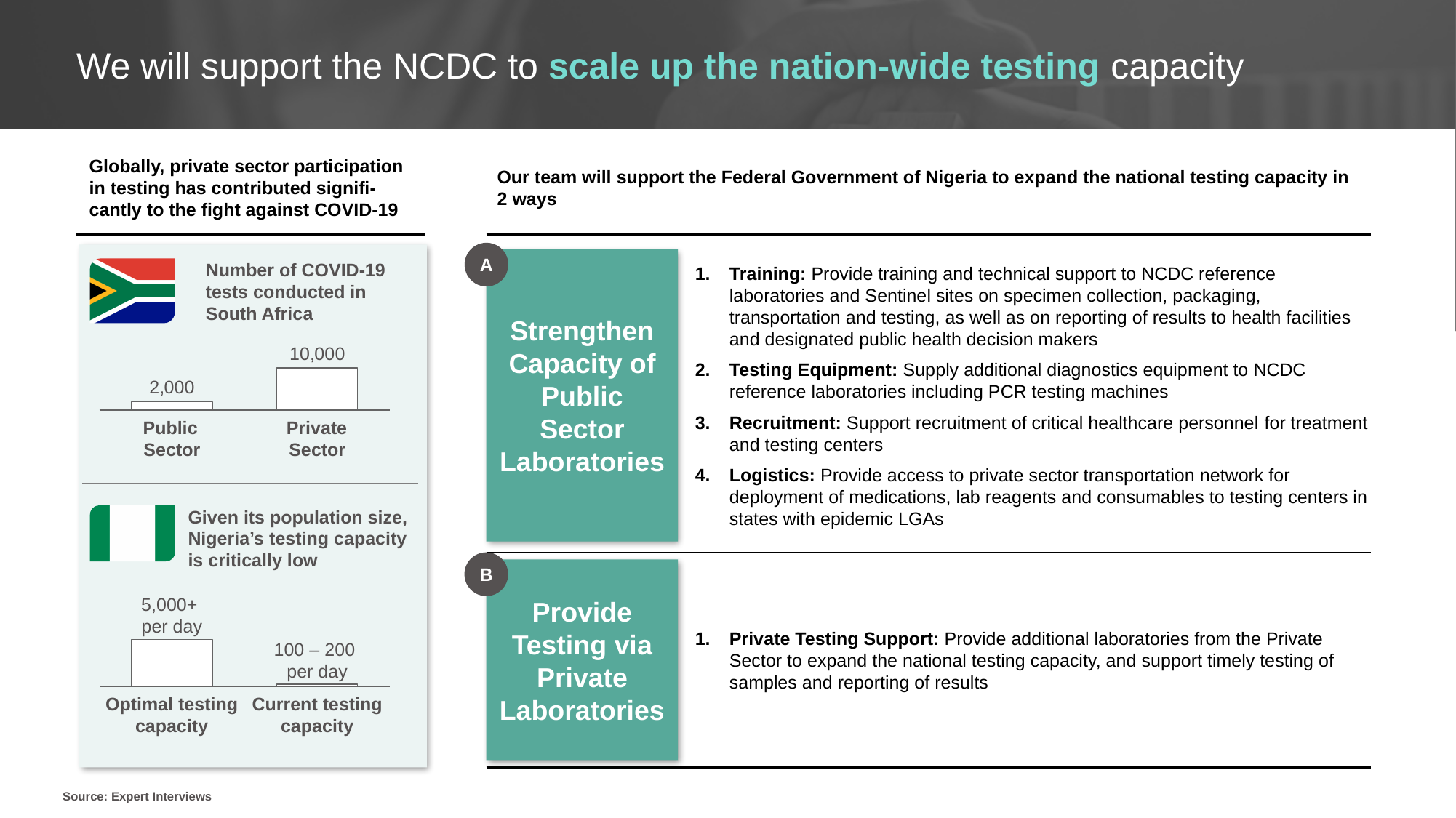
In the 'Number of COVID-19 tests conducted in South Africa' chart, what is the value for the Private Sector? 10,000 In the Nigeria testing capacity chart at the bottom left, how many categories are shown? 2 In the 'Number of COVID-19 tests conducted in South Africa' chart, what is the value for the Public Sector? 2,000 In the Nigeria testing capacity chart at the bottom left, what is the value labelled for Optimal testing capacity? 5,000+ per day In the Nigeria testing capacity chart at the bottom left, what is the value labelled for Current testing capacity? 100 – 200 per day In the 'Number of COVID-19 tests conducted in South Africa' chart, which category has the lowest value? Public Sector What is the title of the top-left chart on the slide? Number of COVID-19 tests conducted in South Africa In the 'Number of COVID-19 tests conducted in South Africa' chart, how many categories are shown? 2 In the 'Number of COVID-19 tests conducted in South Africa' chart, which category has the highest value? Private Sector In the Nigeria testing capacity chart at the bottom left, which category has the larger value, Optimal testing capacity or Current testing capacity? Optimal testing capacity In the 'Number of COVID-19 tests conducted in South Africa' chart, what is the difference between the Private Sector and Public Sector values? 8,000 What type of chart is the 'Number of COVID-19 tests conducted in South Africa' chart? Bar chart